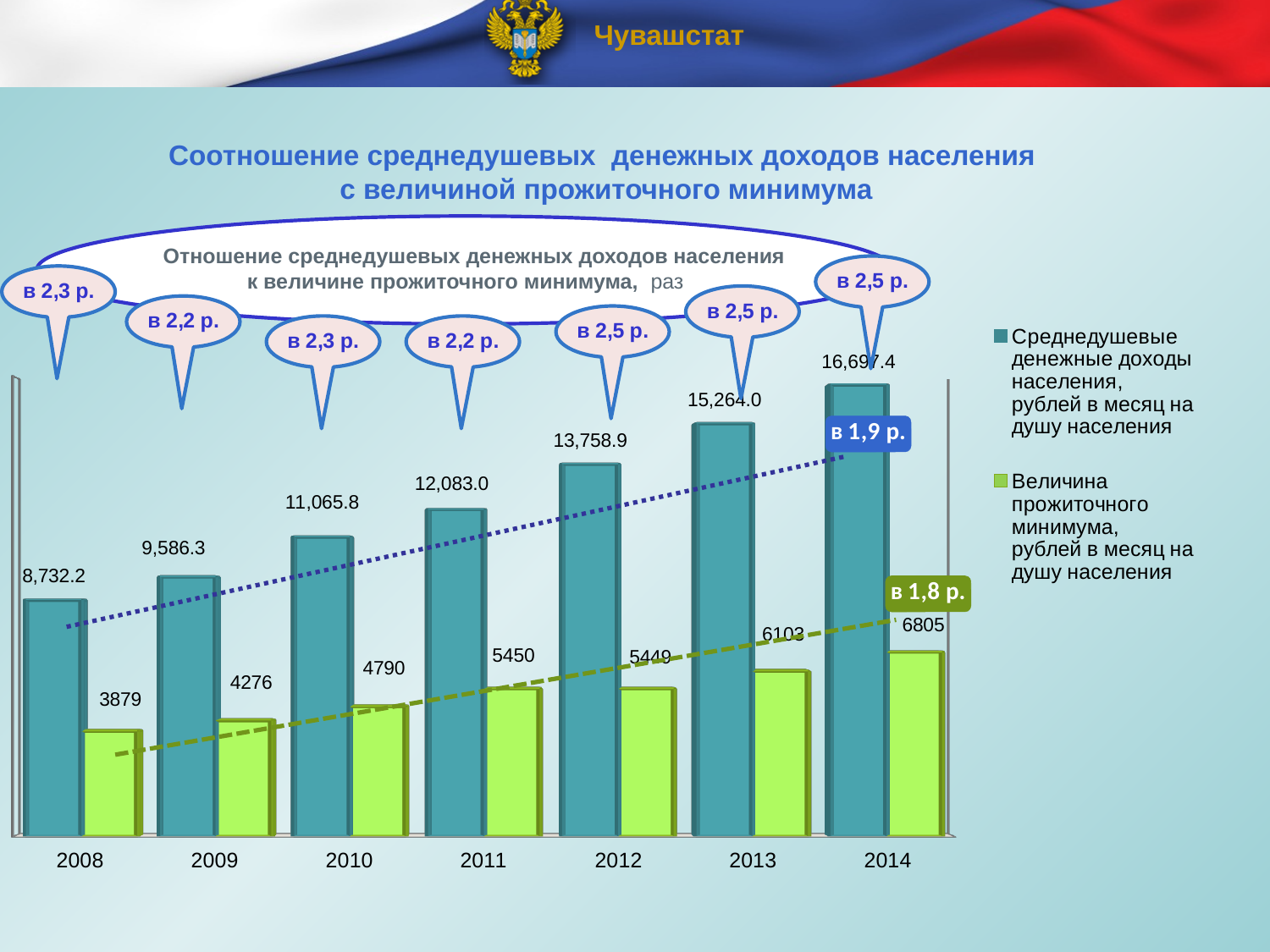
By how much did the average per capita money income increase from 2008 to 2009? 854.1 Which is larger: the subsistence minimum in 2010 or in 2013? 2013 How many years are shown on the x axis of the chart? 7 What kind of chart is used to show the income and subsistence minimum values? Bar chart What is the difference between the subsistence minimum in 2014 and in 2008? 2926 What is the subsistence minimum (Величина прожиточного минимума) shown for 2012? 5449 How many series does the legend list? 2 What is the average per capita money income (Среднедушевые денежные доходы населения) shown for 2010? 11,065.8 Does the average per capita money income rise or fall from 2008 to 2014? Rises In which year is the subsistence minimum the highest? 2014 In which year is the average per capita money income the lowest? 2008 What is the average per capita money income shown for 2013? 15,264.0